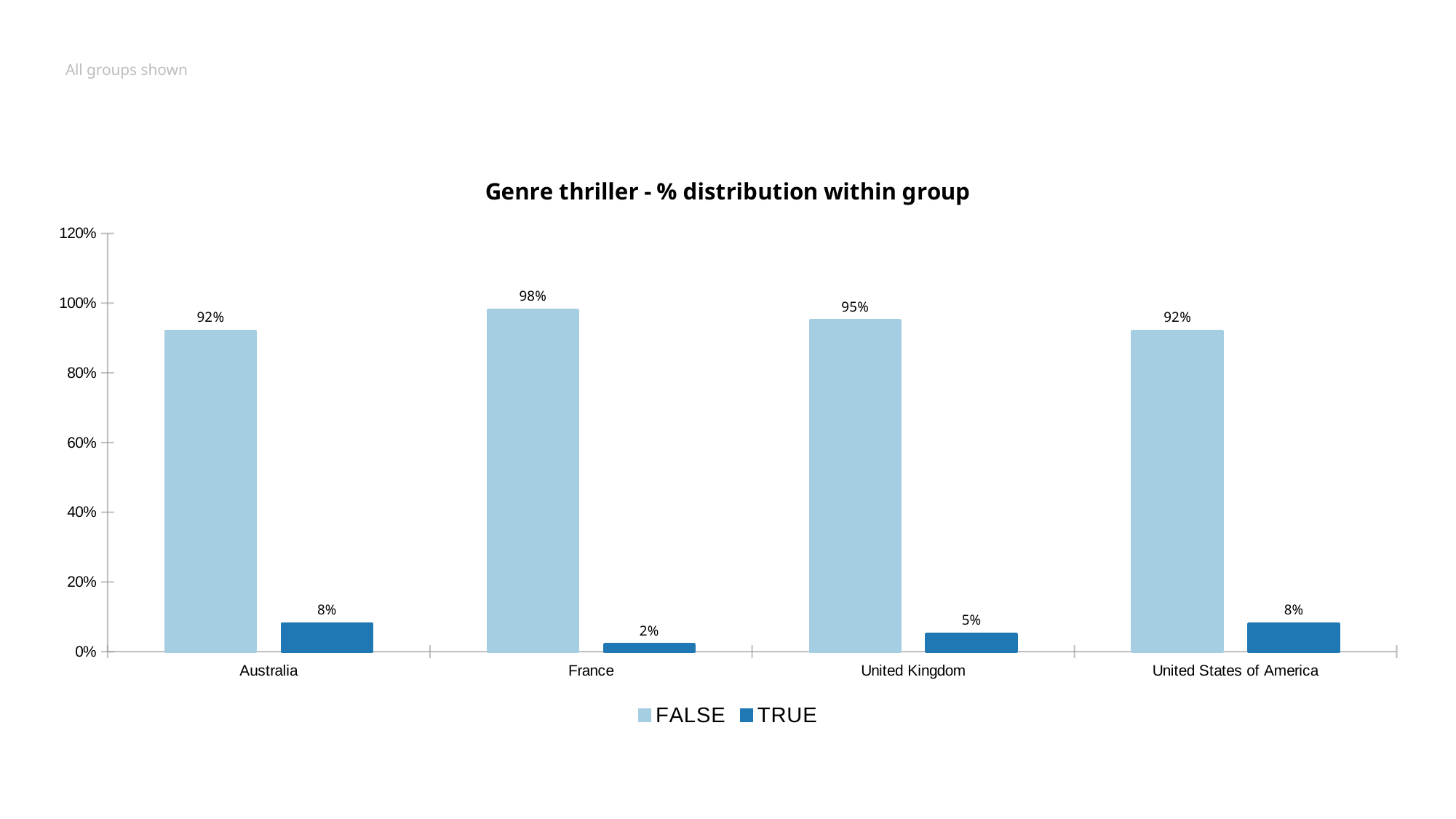
What is the FALSE value for France? 98% How many series does the legend list? 2 Which country has the lowest TRUE value? France What is the TRUE value for Australia? 8% Which country has the highest FALSE value? France What is the difference between the FALSE and TRUE values for the United Kingdom? 90% Is the FALSE value for the United States of America greater or less than 80%? greater Which is larger, the TRUE value for France or the TRUE value for the United Kingdom? United Kingdom How many countries are shown on the x axis? 4 What is the TRUE value for the United Kingdom? 5% What is the title of the chart? Genre thriller - % distribution within group What kind of chart is shown? bar chart